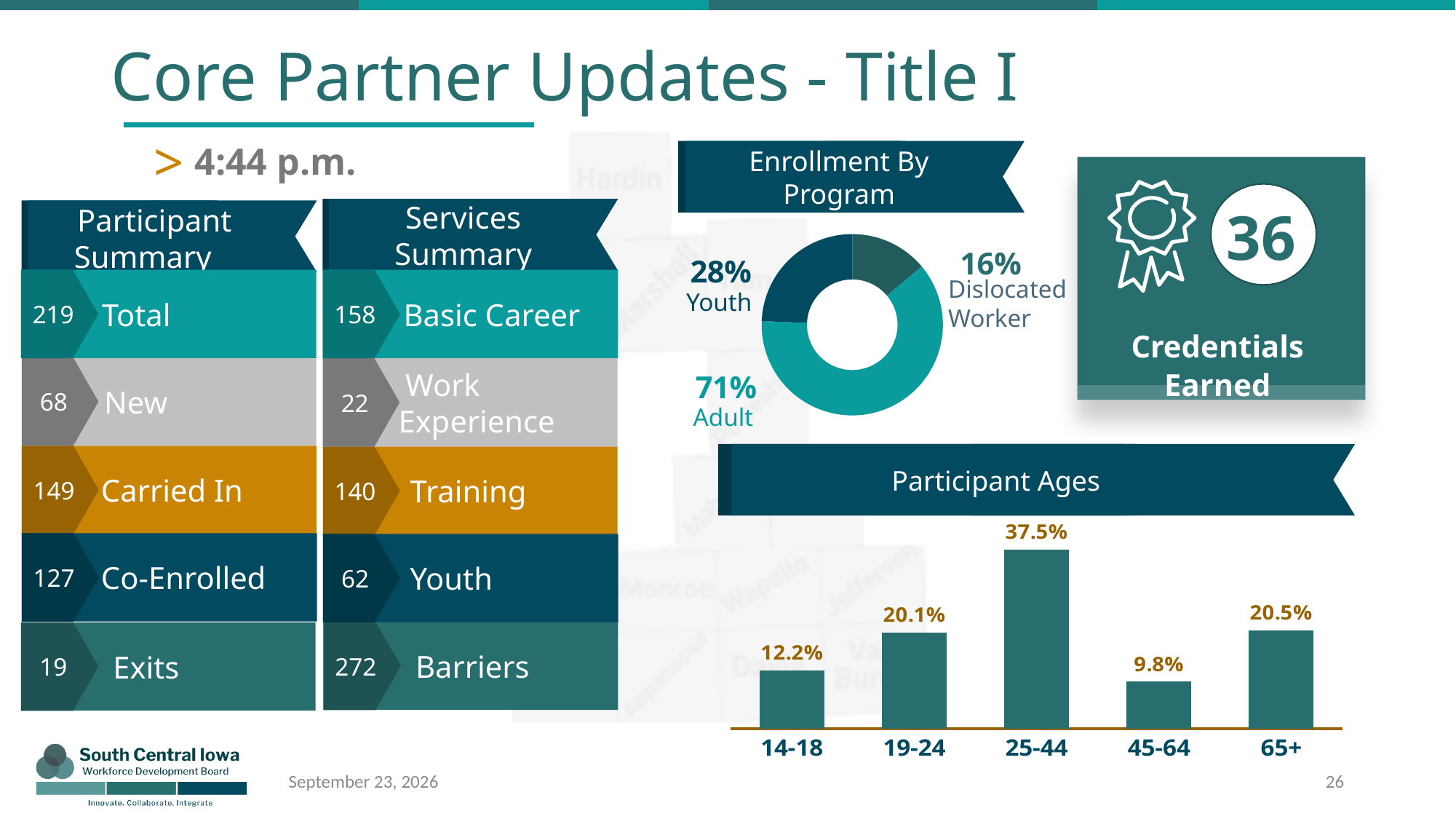
In the Participant Ages chart, which age group has the lowest value? 45-64 In the Enrollment By Program chart, how many program categories are shown? 3 In the Participant Ages chart, what is the difference between the 25-44 and 14-18 values? 25.3% What kind of chart is the Enrollment By Program chart? Doughnut chart In the Enrollment By Program chart, which program has the largest share? Adult In the Enrollment By Program chart, what share of enrollment is Dislocated Worker? 16% What kind of chart is the Participant Ages chart? Bar chart In the Enrollment By Program chart, which program has the smallest share? Dislocated Worker In the Participant Ages chart, what is the value for the 25-44 age group? 37.5% In the Enrollment By Program chart, what share of enrollment is Adult? 71% In the Participant Ages chart, what is the value for the 45-64 age group? 9.8% In the Participant Ages chart, which is larger, the value for 19-24 or the value for 65+? 65+